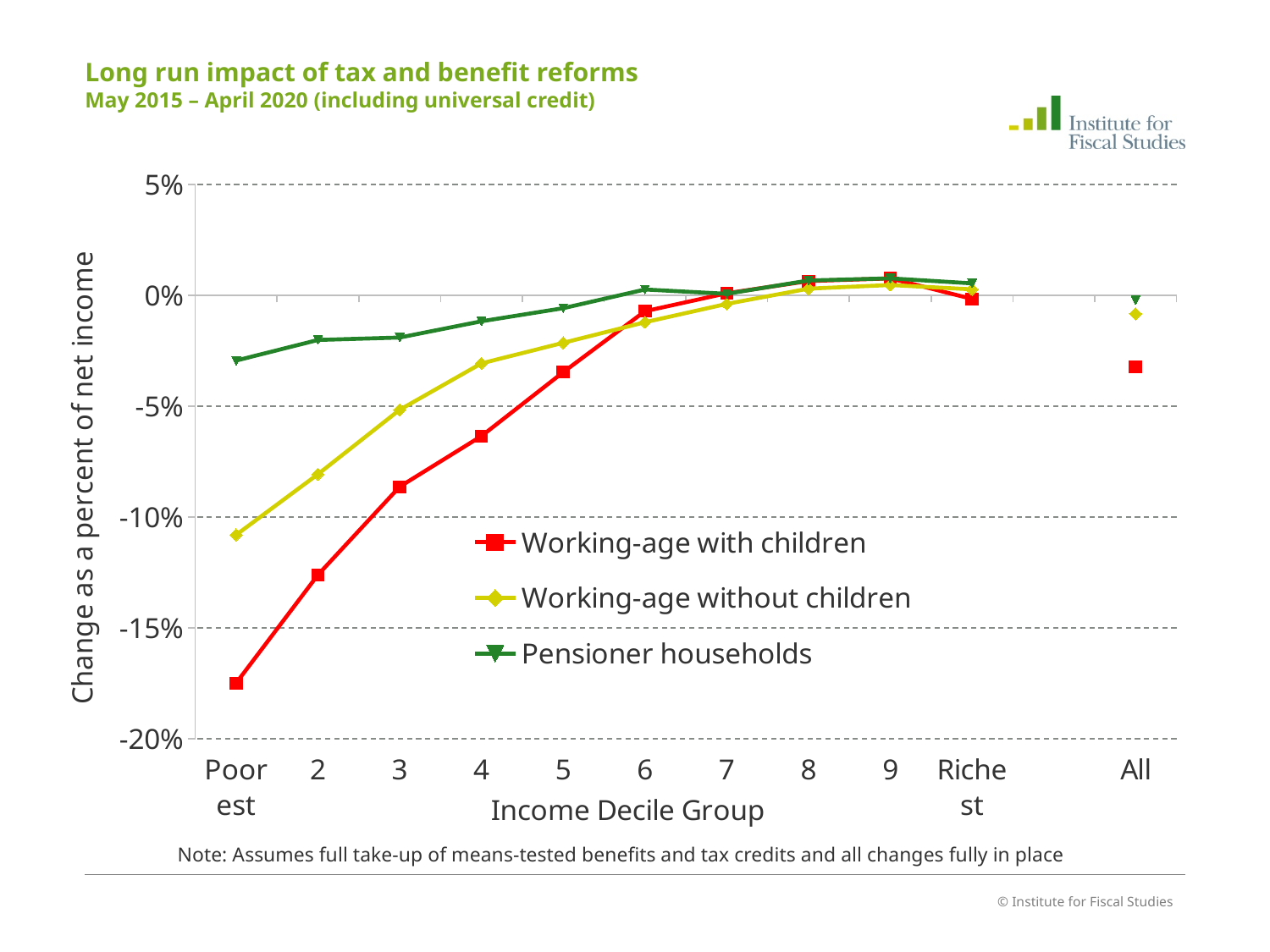
Is the value for Working-age with children in decile 3 greater or less than -10%? greater Is the value for Working-age with children in decile 4 greater or less than -5%? less How many series does the legend list? 3 What kind of chart is shown on the slide? line chart Does the Working-age with children series rise or fall from the Poorest decile to decile 9? rise In the Poorest decile, which is larger: the value for Pensioner households or the value for Working-age with children? Pensioner households For the Working-age with children series, which income decile group has the lowest value? Poorest How many categories are shown along the x axis? 11 Is the value for Pensioner households in the Poorest decile greater or less than -5%? greater What is the label on the vertical axis of the chart? Change as a percent of net income